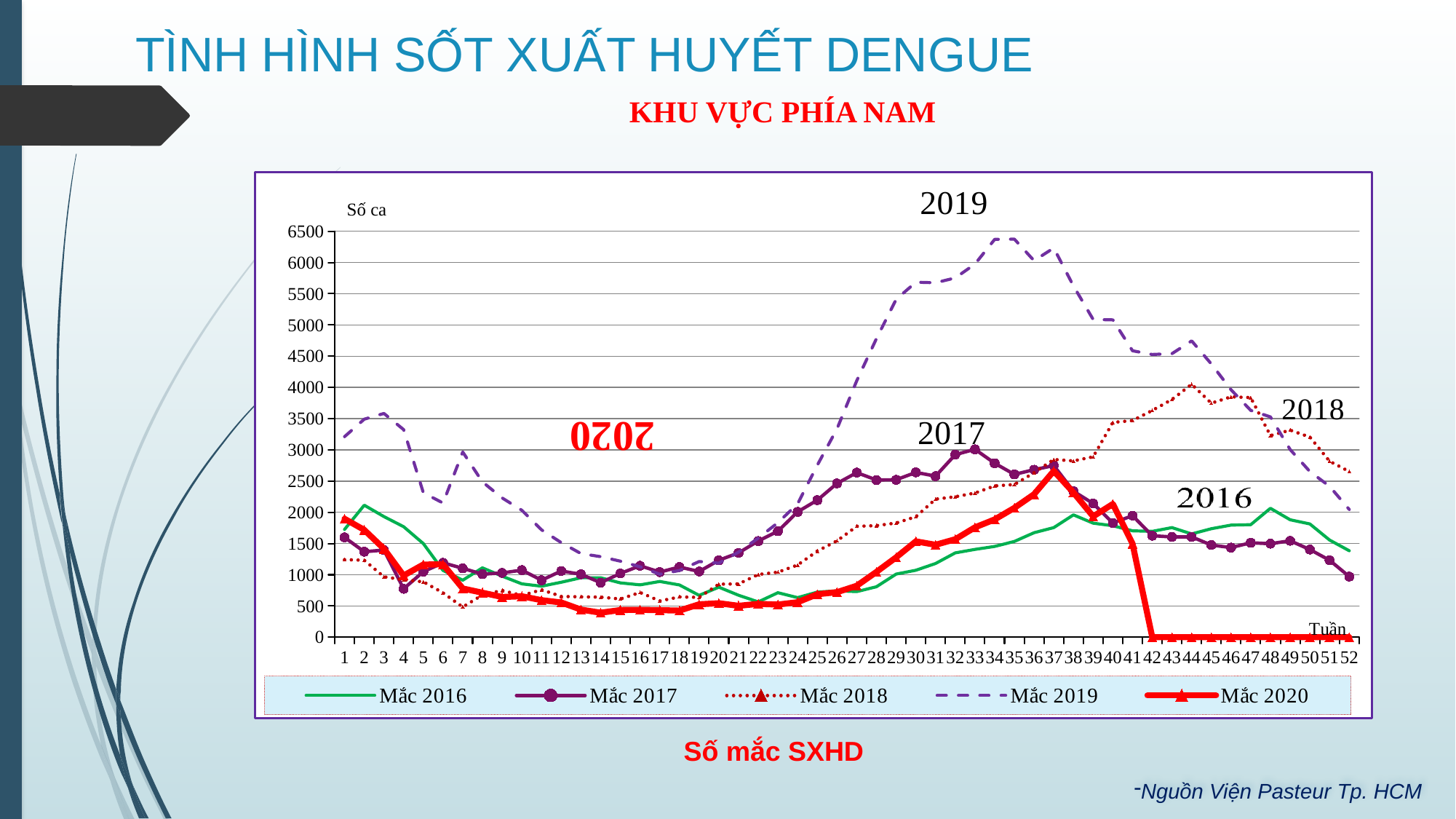
How many weeks are shown along the x axis? 52 Does the Mắc 2019 series rise or fall from week 37 to week 52? fall At week 37, which is larger, Mắc 2019 or Mắc 2016? Mắc 2019 How many series does the legend list? 5 Which series has the lowest value at week 52? Mắc 2020 Which series reaches the highest value on the chart? Mắc 2019 Is the value for Mắc 2017 at week 33 greater or less than 2500? greater What kind of chart is shown on the slide? line chart Is the value for Mắc 2018 at week 44 greater or less than 3500? greater What is the value for Mắc 2020 at week 50? 0 What is the label on the vertical axis of the chart? Số ca Is the value for Mắc 2019 at week 35 greater or less than 6000? greater